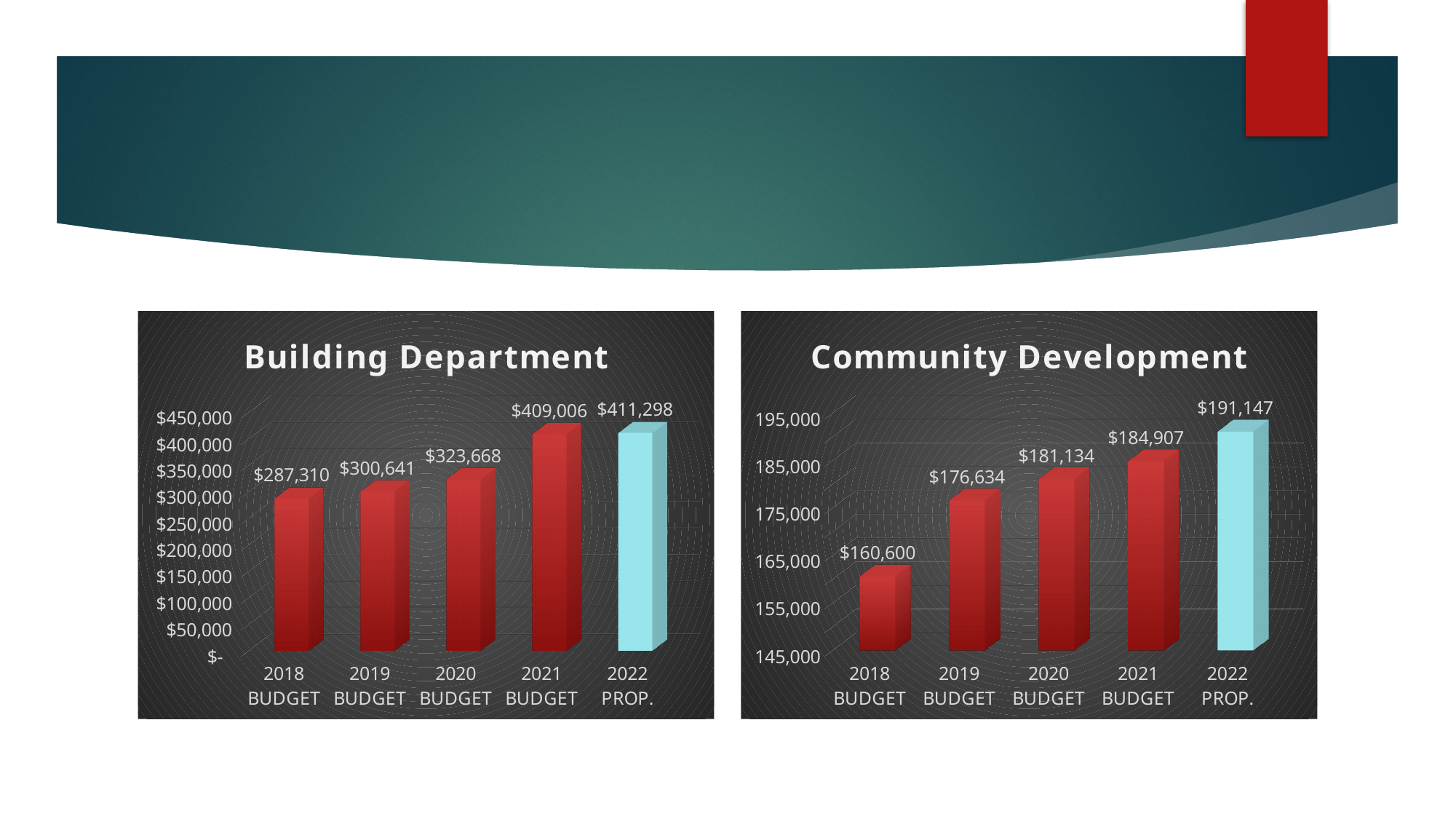
In the Community Development chart, what is the difference between the 2022 PROP. value and the 2018 BUDGET value? $30,547 In the Building Department chart, which category has the lowest value? 2018 BUDGET In the Community Development chart, which is larger, the 2020 BUDGET value or the 2021 BUDGET value? 2021 BUDGET In the Building Department chart, do the values rise or fall from 2018 BUDGET to 2022 PROP.? rise In the Community Development chart, what is the value for 2019 BUDGET? $176,634 In the Building Department chart, which category has the highest value? 2022 PROP. In the Building Department chart, what is the difference between the 2022 PROP. value and the 2021 BUDGET value? $2,292 In the Community Development chart, what colour is the 2022 PROP. bar? light blue In the Building Department chart, what is the value for 2020 BUDGET? $323,668 In the Building Department chart, how many categories are shown on the x axis? 5 In the Community Development chart, what is the value for 2018 BUDGET? $160,600 What kind of chart is the Community Development chart? bar chart